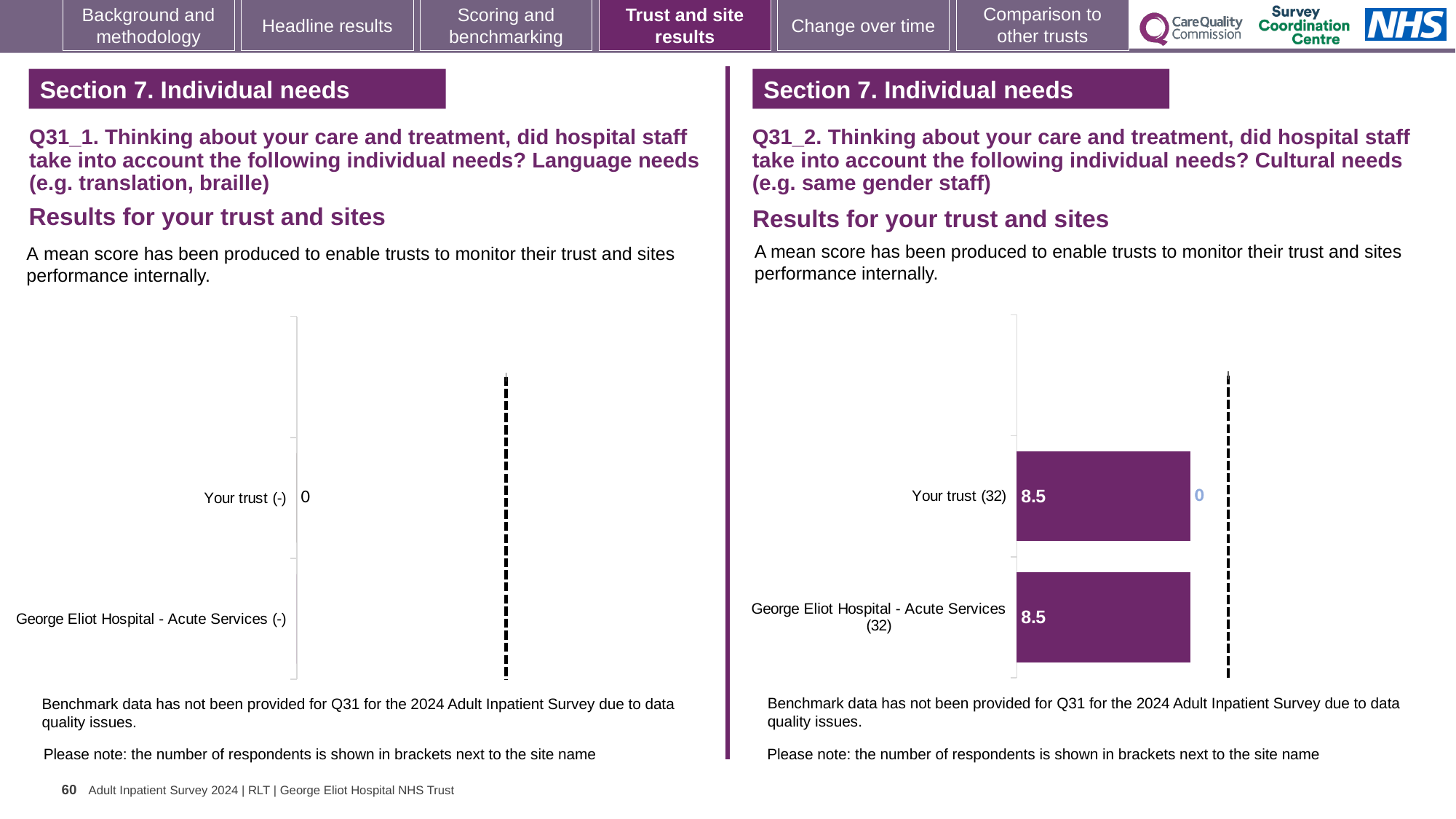
What kind of chart is the Q31_2 Cultural needs chart on the right? Bar chart On the Q31_2 Cultural needs chart (right), what is the value for George Eliot Hospital - Acute Services (32)? 8.5 On the Q31_1 Language needs chart (left), how many categories are listed on the axis? 2 On the Q31_2 Cultural needs chart (right), how many categories are plotted? 2 On the Q31_2 Cultural needs chart (right), how many respondents are shown in brackets next to Your trust? 32 On the Q31_2 Cultural needs chart (right), what is the value for Your trust (32)? 8.5 On the Q31_1 Language needs chart (left), what value is shown next to Your trust (-)? 0 On the Q31_1 Language needs chart (left), what is the label of the second category on the axis? George Eliot Hospital - Acute Services (-) On the Q31_2 Cultural needs chart (right), what colour are the bars? Purple On the Q31_2 Cultural needs chart (right), what is the difference between the value for Your trust (32) and the value for George Eliot Hospital - Acute Services (32)? 0